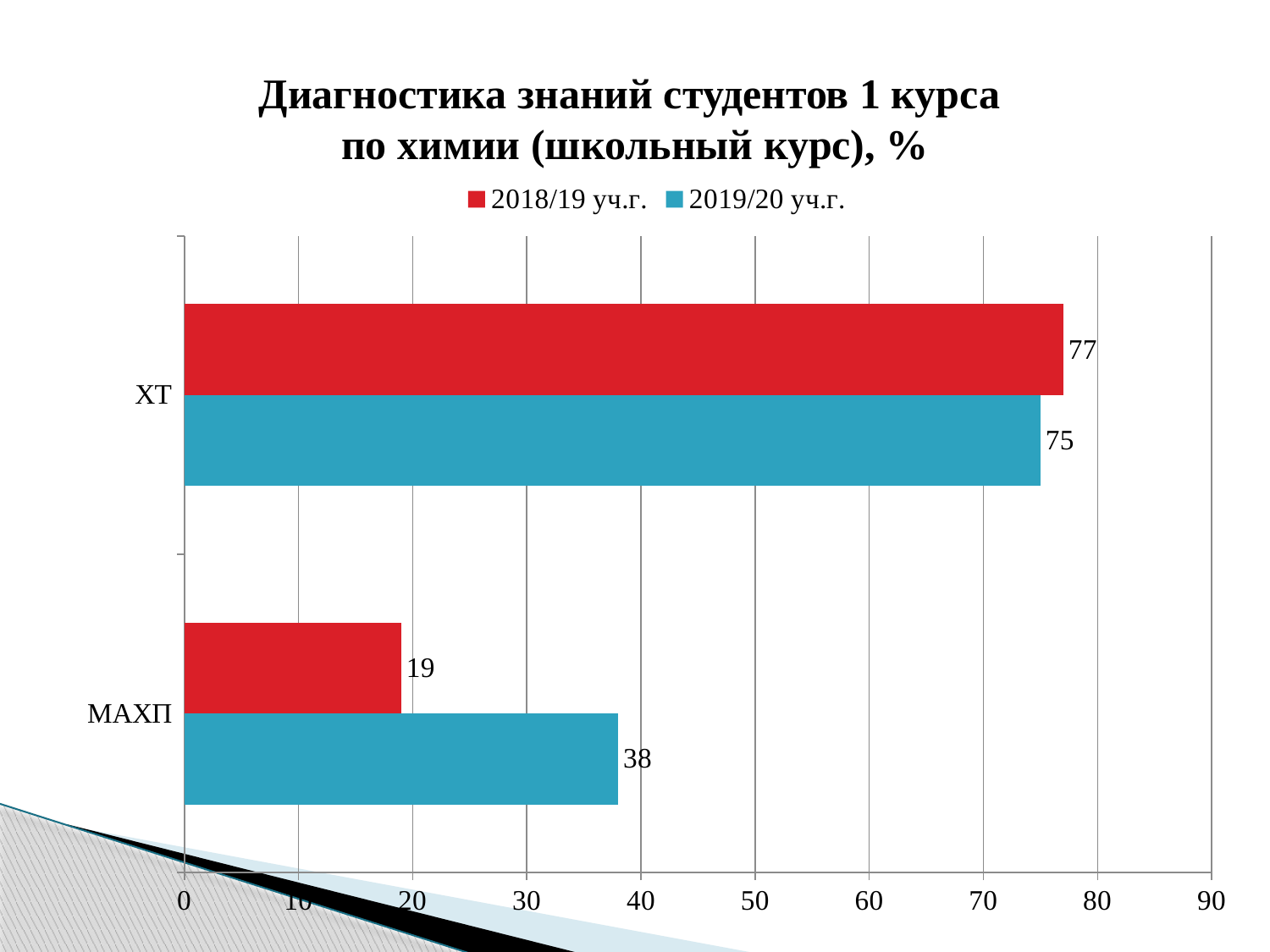
What is the value for ХТ in the 2019/20 уч.г. series? 75 What is the difference between the 2018/19 уч.г. and 2019/20 уч.г. values for ХТ? 2 Which category has the highest value in the 2019/20 уч.г. series? ХТ What is the difference between the 2019/20 уч.г. and 2018/19 уч.г. values for МАХП? 19 What is the value for МАХП in the 2019/20 уч.г. series? 38 For МАХП, which series has the larger value: 2018/19 уч.г. or 2019/20 уч.г.? 2019/20 уч.г. How many series does the legend list? 2 What kind of chart is shown on the slide? Bar chart What is the value for ХТ in the 2018/19 уч.г. series? 77 What is the value for МАХП in the 2018/19 уч.г. series? 19 Which category has the lowest value in the 2018/19 уч.г. series? МАХП How many categories are shown on the chart? 2